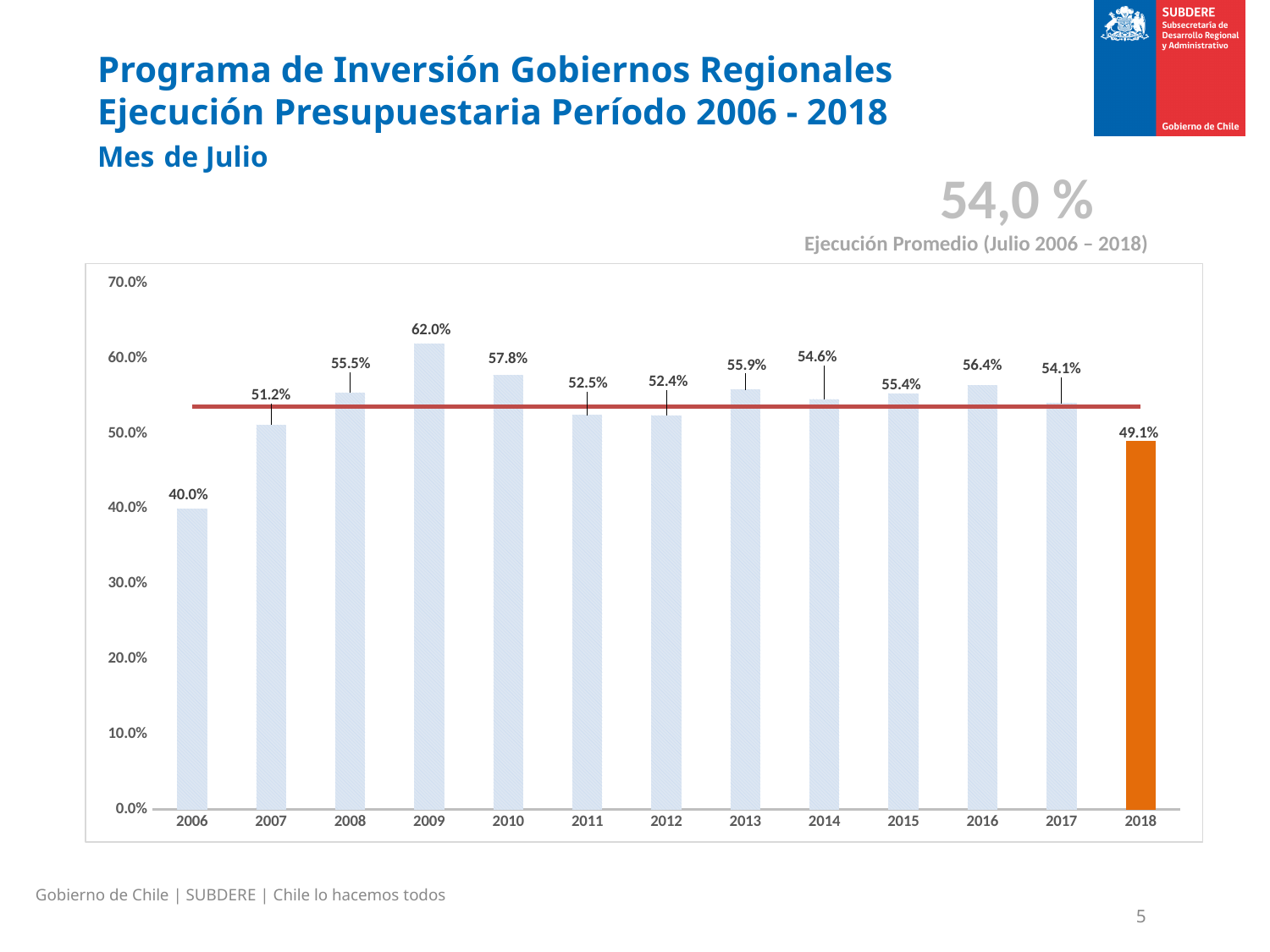
Which year has the highest value? 2009 What kind of chart is this? bar chart What average value is shown above the chart for Ejecución Promedio (Julio 2006 – 2018)? 54,0 % What is the value for 2006? 40.0% What is the value for 2018? 49.1% Which year has the lowest value? 2006 What is the value for 2009? 62.0% Which is larger, the value for 2010 or the value for 2011? 2010 Do the values rise or fall from 2006 to 2009? rise Is the value for 2016 greater or less than 50.0%? greater How many years are shown on the x axis? 13 What is the difference between the values for 2009 and 2006? 22.0%